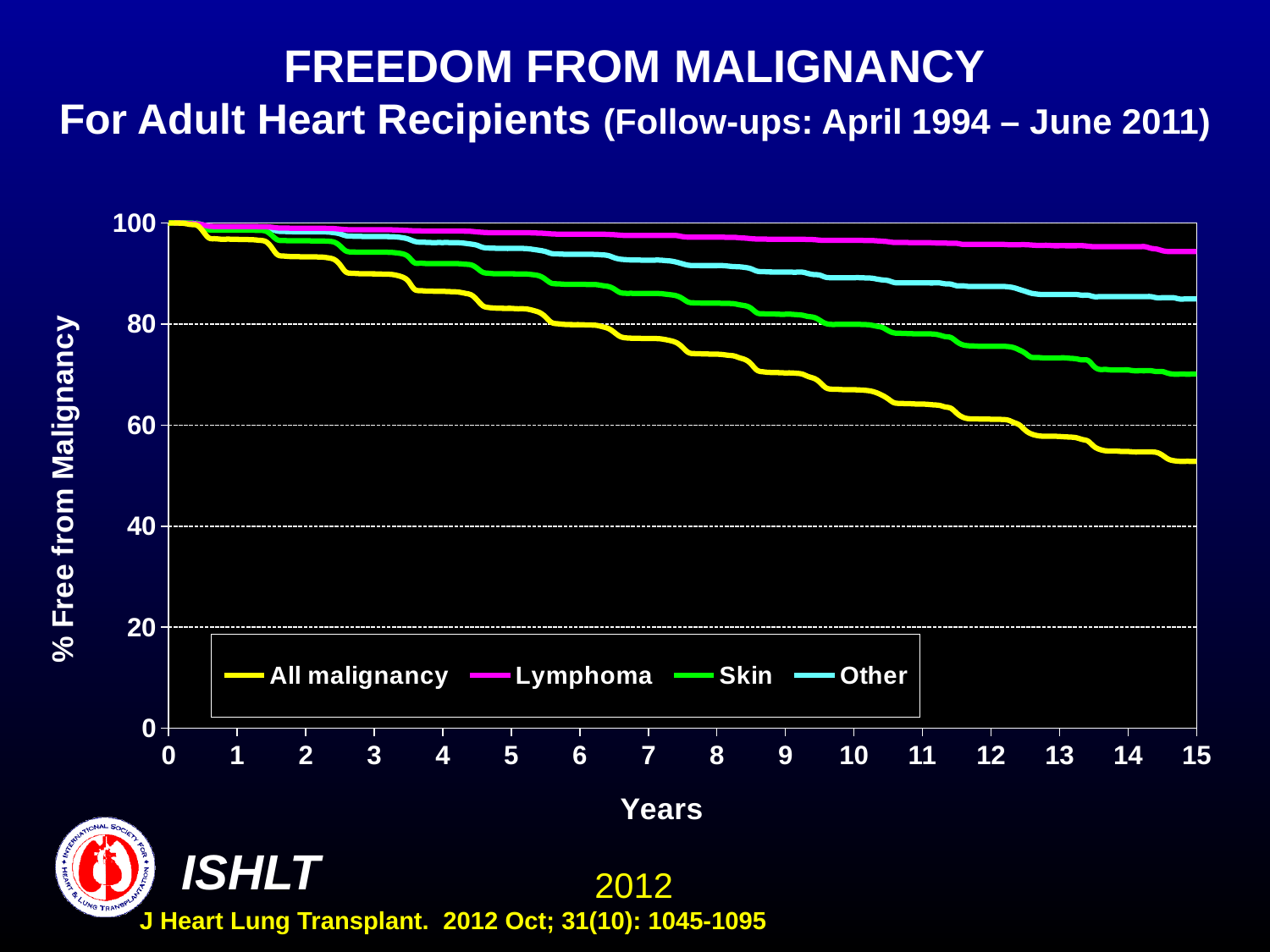
Do the values for All malignancy rise or fall as years increase? fall Is the value for Skin at 15 years greater or less than 60? greater Is the value for All malignancy at 15 years greater or less than 60? less Is the value for Lymphoma at 15 years greater or less than 80? greater How many series does the legend list? 4 What kind of chart is shown on the slide? line chart What colour is the line for Skin? green What is the label on the y axis? % Free from Malignancy At 10 years, which is larger: the value for Skin or the value for Other? Other Which series has the lowest value at 15 years? All malignancy Which series has the highest value at 15 years? Lymphoma